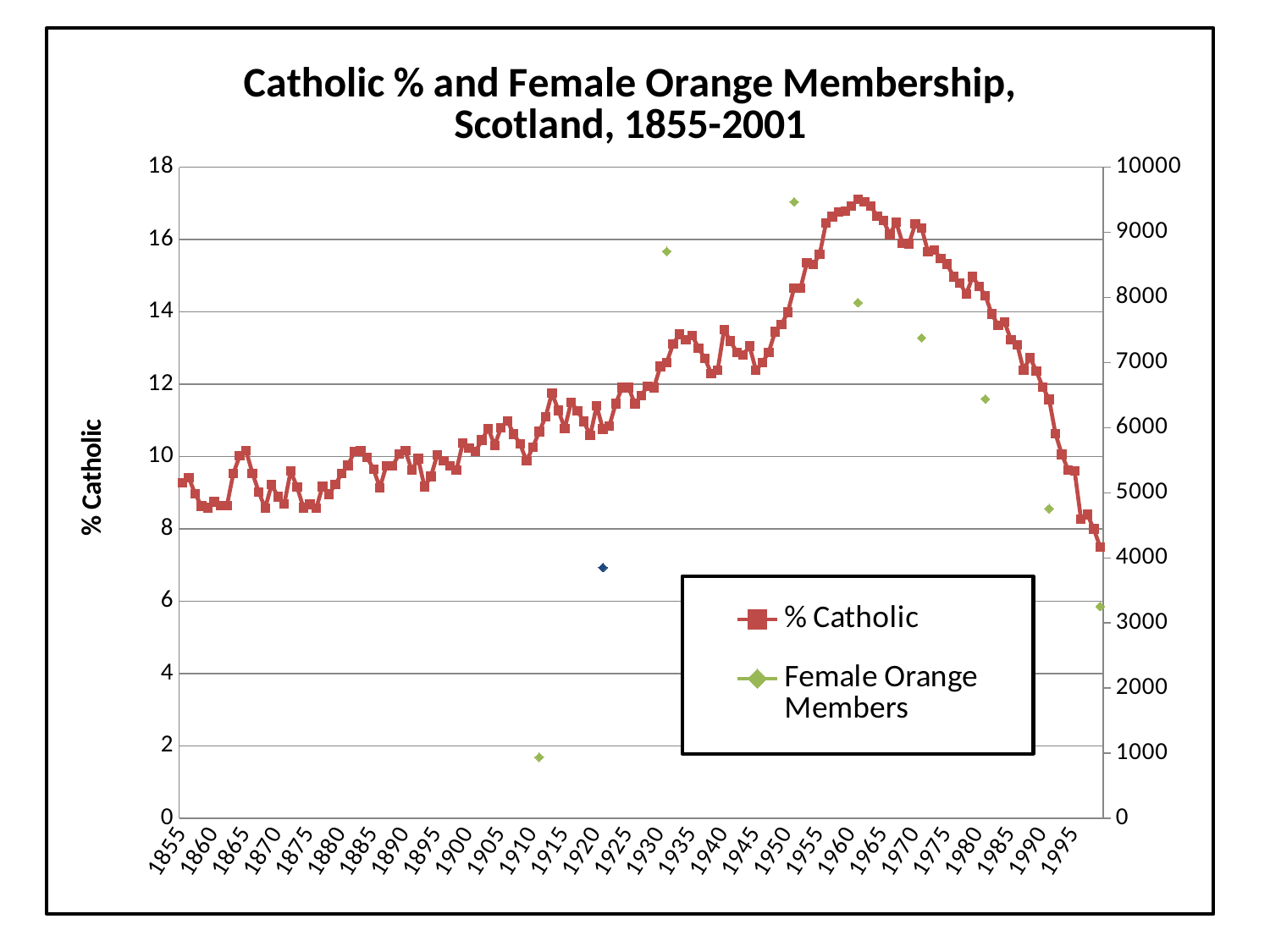
Is the peak % Catholic value, reached in the early 1960s, greater or less than 16? greater How many series does the legend list? 2 What kind of chart is shown on the slide? line chart Which series is plotted with green diamond markers? Female Orange Members Is the Female Orange Members value plotted around 1952 greater or less than 9000? greater Which is larger, the Female Orange Members value around 1952 or around 1992? around 1952 Is the Female Orange Members value plotted around 1912 greater or less than 1000? less Does the % Catholic series rise or fall between 1965 and 2000? fall Which is larger, the % Catholic value in 1960 or in 1900? 1960 What is the title of the chart? Catholic % and Female Orange Membership, Scotland, 1855-2001